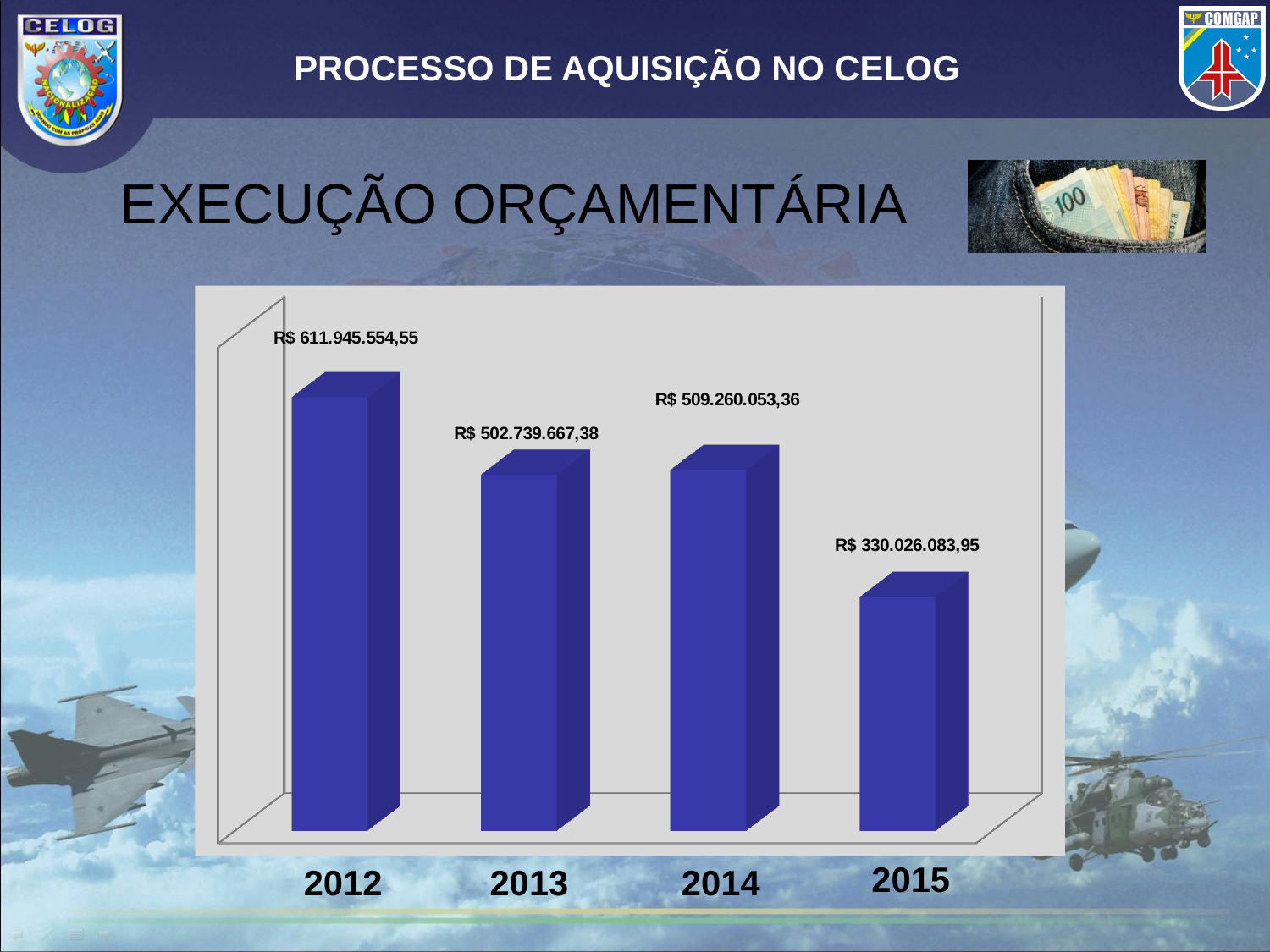
What is the value shown for 2014? R$ 509.260.053,36 What is the value shown for 2015? R$ 330.026.083,95 What is the difference between the values for 2014 and 2013? R$ 6.520.385,98 What is the difference between the values for 2012 and 2015? R$ 281.919.470,60 Overall, do the values rise or fall from 2012 to 2015? Fall Which year has the lowest value? 2015 Which year has the highest value? 2012 What kind of chart is shown on the slide? Bar chart How many years are shown on the chart? 4 What is the value shown for 2013? R$ 502.739.667,38 What is the value shown for 2012? R$ 611.945.554,55 Which is larger, the value for 2013 or the value for 2014? 2014